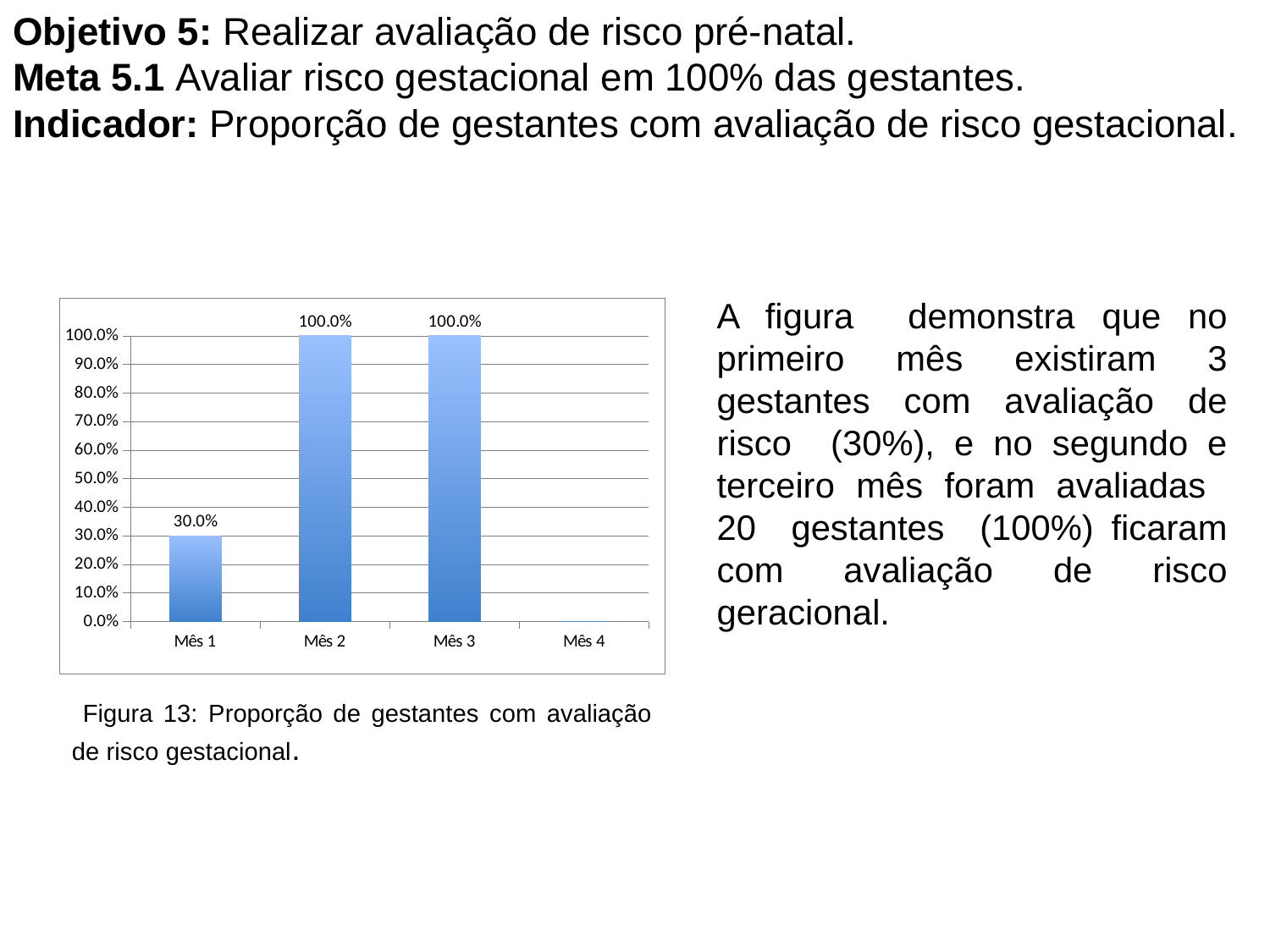
What is the value for Mês 3? 100.0% What is the value for Mês 1? 30.0% Among Mês 1, Mês 2 and Mês 3, which month has the lowest value? Mês 1 Which is larger, the value for Mês 1 or the value for Mês 3? Mês 3 What is the difference between the values for Mês 2 and Mês 1? 70.0% How many month categories are shown on the x axis? 4 What figure number is given in the caption below the chart? Figura 13 What is the value for Mês 2? 100.0% What kind of chart is shown on the slide? bar chart Does the value rise or fall from Mês 1 to Mês 2? rise Is the value for Mês 1 greater or less than 50.0%? less Is the value for Mês 2 greater or less than 90.0%? greater